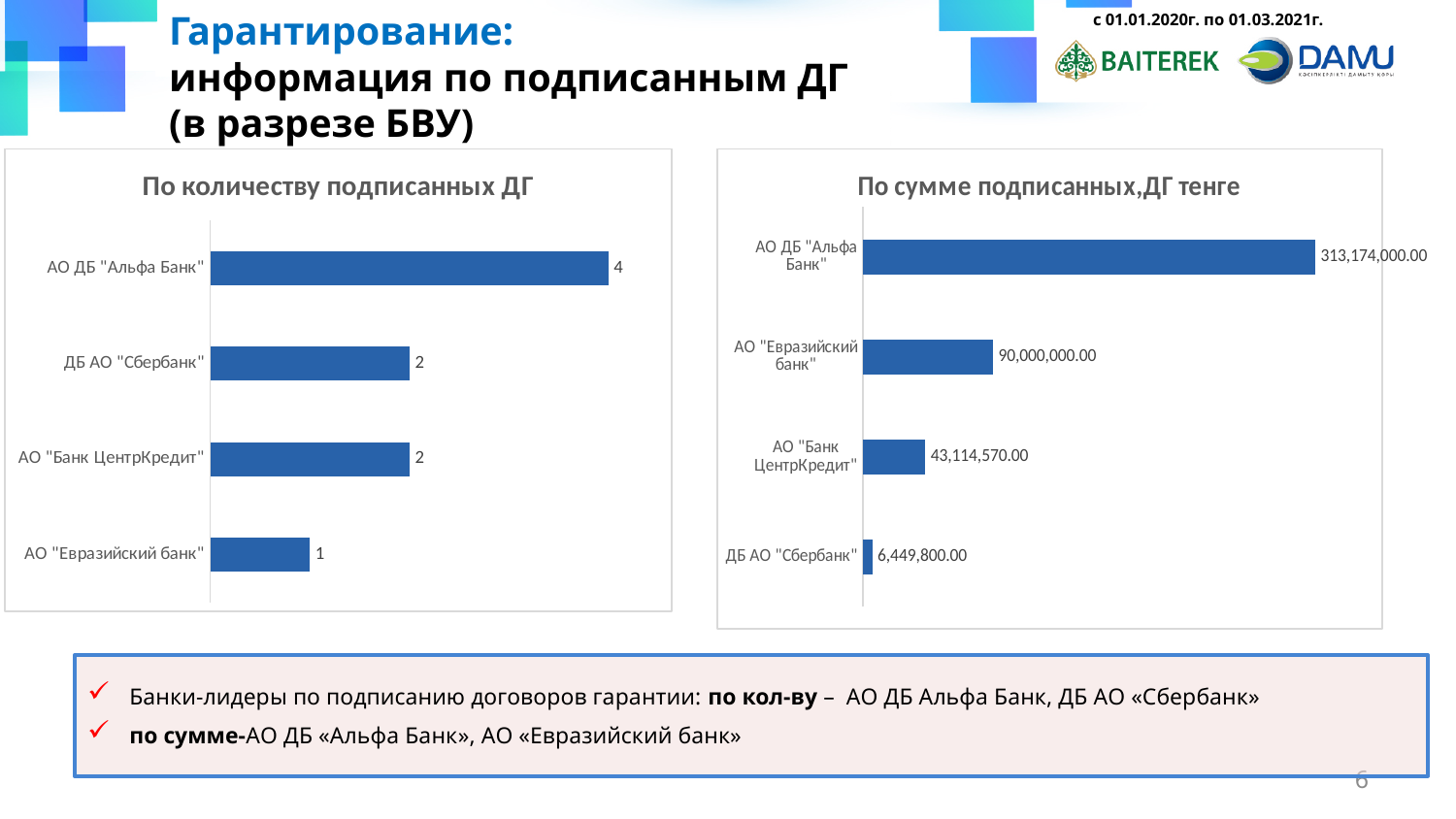
In the chart "По количеству подписанных ДГ", what is the difference between the values for АО ДБ "Альфа Банк" and ДБ АО "Сбербанк"? 2 In the chart "По сумме подписанных,ДГ тенге", which is larger: the value for АО "Евразийский банк" or АО "Банк ЦентрКредит"? АО "Евразийский банк" What type of chart is "По сумме подписанных,ДГ тенге"? Bar chart In the chart "По количеству подписанных ДГ", which bank has the highest value? АО ДБ "Альфа Банк" In the chart "По сумме подписанных,ДГ тенге", what is the value for АО "Банк ЦентрКредит"? 43,114,570.00 In the chart "По количеству подписанных ДГ", which bank has the lowest value? АО "Евразийский банк" How many banks are shown in the chart "По количеству подписанных ДГ"? 4 In the chart "По количеству подписанных ДГ", what is the value for АО ДБ "Альфа Банк"? 4 In the chart "По сумме подписанных,ДГ тенге", what is the value for АО "Евразийский банк"? 90,000,000.00 In the chart "По количеству подписанных ДГ", what is the value for АО "Евразийский банк"? 1 In the chart "По сумме подписанных,ДГ тенге", which bank has the highest value? АО ДБ "Альфа Банк" In the chart "По сумме подписанных,ДГ тенге", what is the value for ДБ АО "Сбербанк"? 6,449,800.00